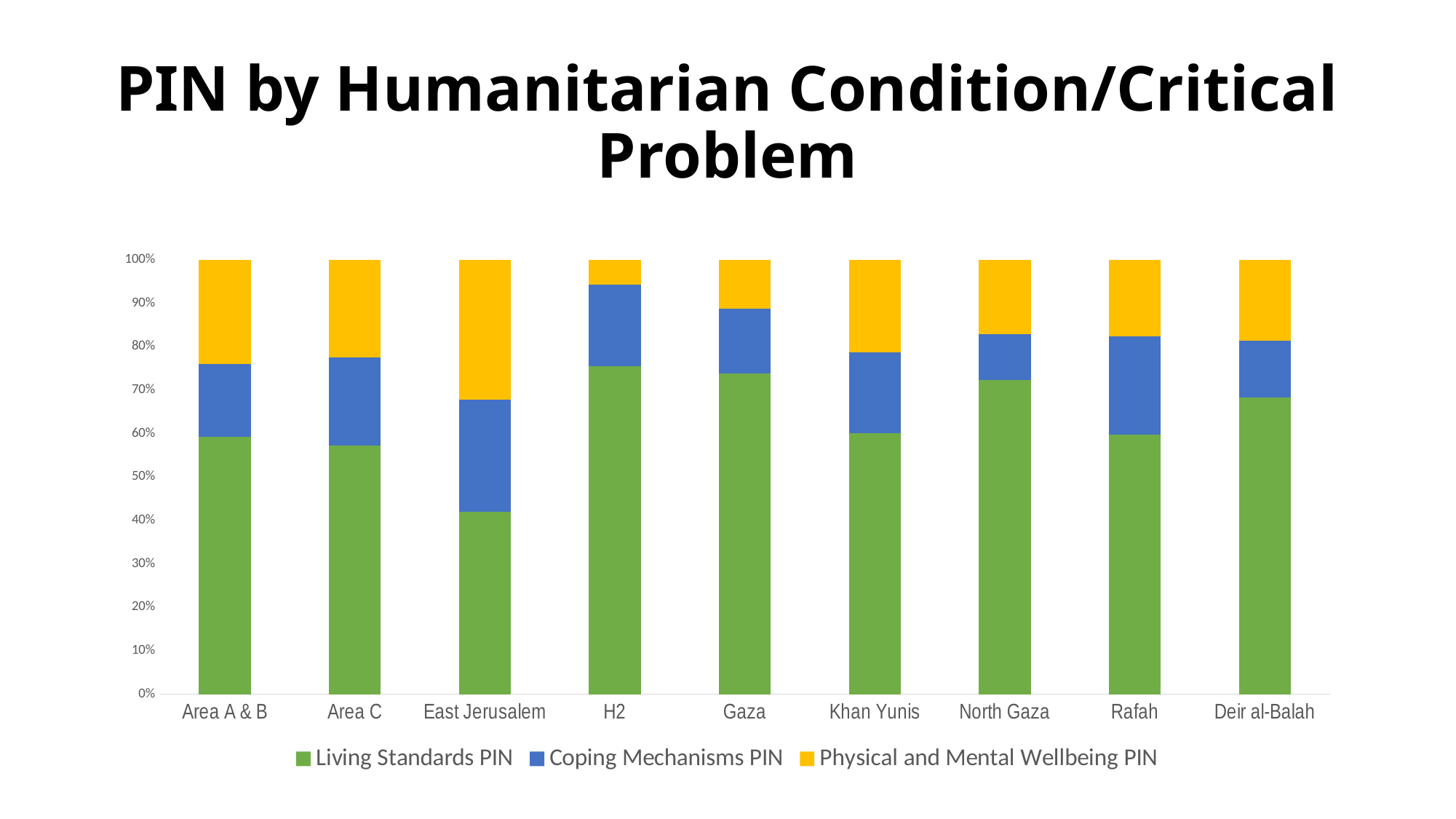
Which category has the lowest Living Standards PIN share? East Jerusalem What is the total height of the Area C stacked bar? 100% What kind of chart is shown on the slide? Stacked bar chart Is the Living Standards PIN share for East Jerusalem greater or less than 50%? less Which category has the smallest Physical and Mental Wellbeing PIN share? H2 Which colour represents Coping Mechanisms PIN in the legend? Blue Which has a larger Living Standards PIN share, H2 or East Jerusalem? H2 How many categories are shown along the x axis? 9 How many series does the legend list? 3 Which category has the largest Physical and Mental Wellbeing PIN share? East Jerusalem Which has a larger Physical and Mental Wellbeing PIN share, Area A & B or Gaza? Area A & B Is the Living Standards PIN share for H2 greater or less than 70%? greater